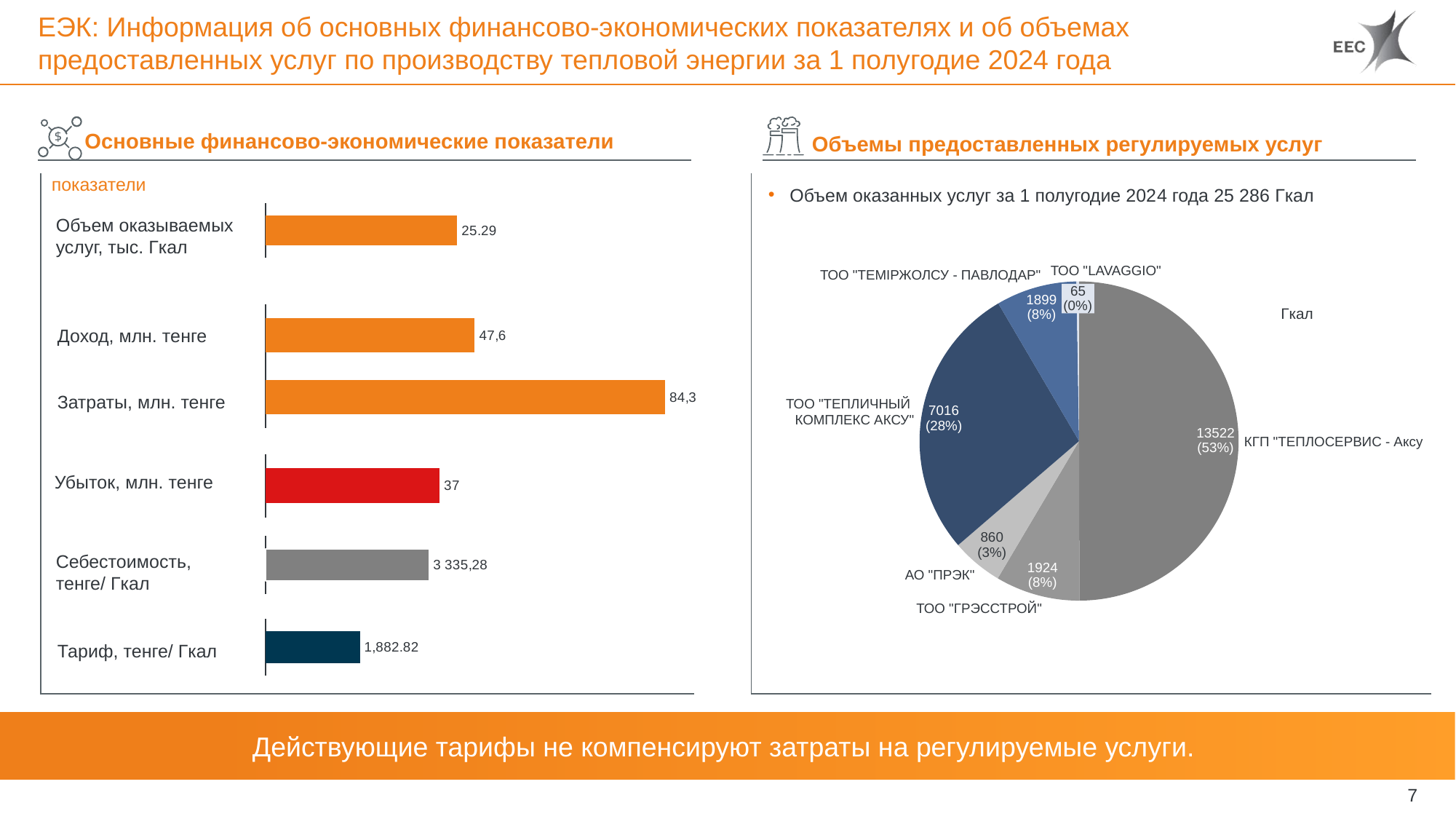
On the left chart 'Основные финансово-экономические показатели', how many categories are plotted? 6 On the left chart 'Основные финансово-экономические показатели', what is the difference between 'Затраты, млн. тенге' and 'Доход, млн. тенге'? 36,7 What kind of chart is the left chart 'Основные финансово-экономические показатели'? Bar chart On the right chart 'Объемы предоставленных регулируемых услуг', which slice is the largest? КГП "ТЕПЛОСЕРВИС - Аксу" On the right chart 'Объемы предоставленных регулируемых услуг', which slice is the smallest? ТОО "LAVAGGIO" On the right chart 'Объемы предоставленных регулируемых услуг', what share of the pie does ТОО "ТЕПЛИЧНЫЙ КОМПЛЕКС АКСУ" have? 28% On the left chart 'Основные финансово-экономические показатели', which is larger: 'Доход, млн. тенге' or 'Затраты, млн. тенге'? Затраты, млн. тенге On the right chart 'Объемы предоставленных регулируемых услуг', how many slices does the pie have? 6 On the right chart 'Объемы предоставленных регулируемых услуг', what is the value for КГП "ТЕПЛОСЕРВИС - Аксу"? 13522 On the left chart 'Основные финансово-экономические показатели', what is the value for 'Себестоимость, тенге/ Гкал'? 3 335,28 On the left chart 'Основные финансово-экономические показатели', what is the value for 'Тариф, тенге/ Гкал'? 1,882.82 On the left chart 'Основные финансово-экономические показатели', what is the value for 'Затраты, млн. тенге'? 84,3